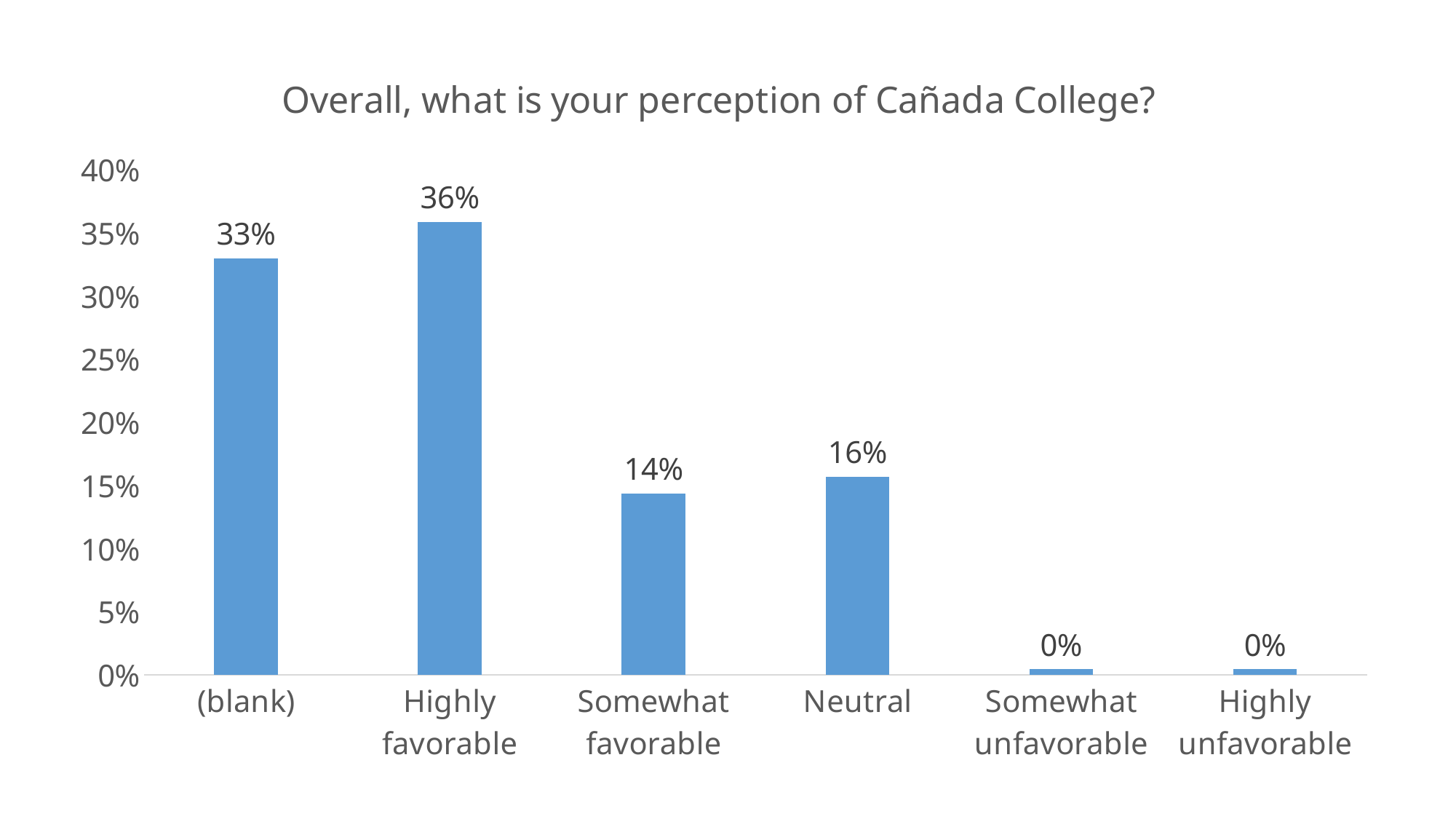
What is the difference between (blank) and Neutral? 17% Is the value for (blank) greater or less than 30%? greater What is the value for (blank)? 33% Which category has the highest value? Highly favorable Which is larger, Neutral or Somewhat favorable? Neutral What is the difference between Highly favorable and Somewhat favorable? 22% What kind of chart is this? bar chart What is the title of the chart? Overall, what is your perception of Cañada College? What is the value for Somewhat favorable? 14% What is the value for Neutral? 16% How many categories are shown on the x axis? 6 What is the value for Highly favorable? 36%